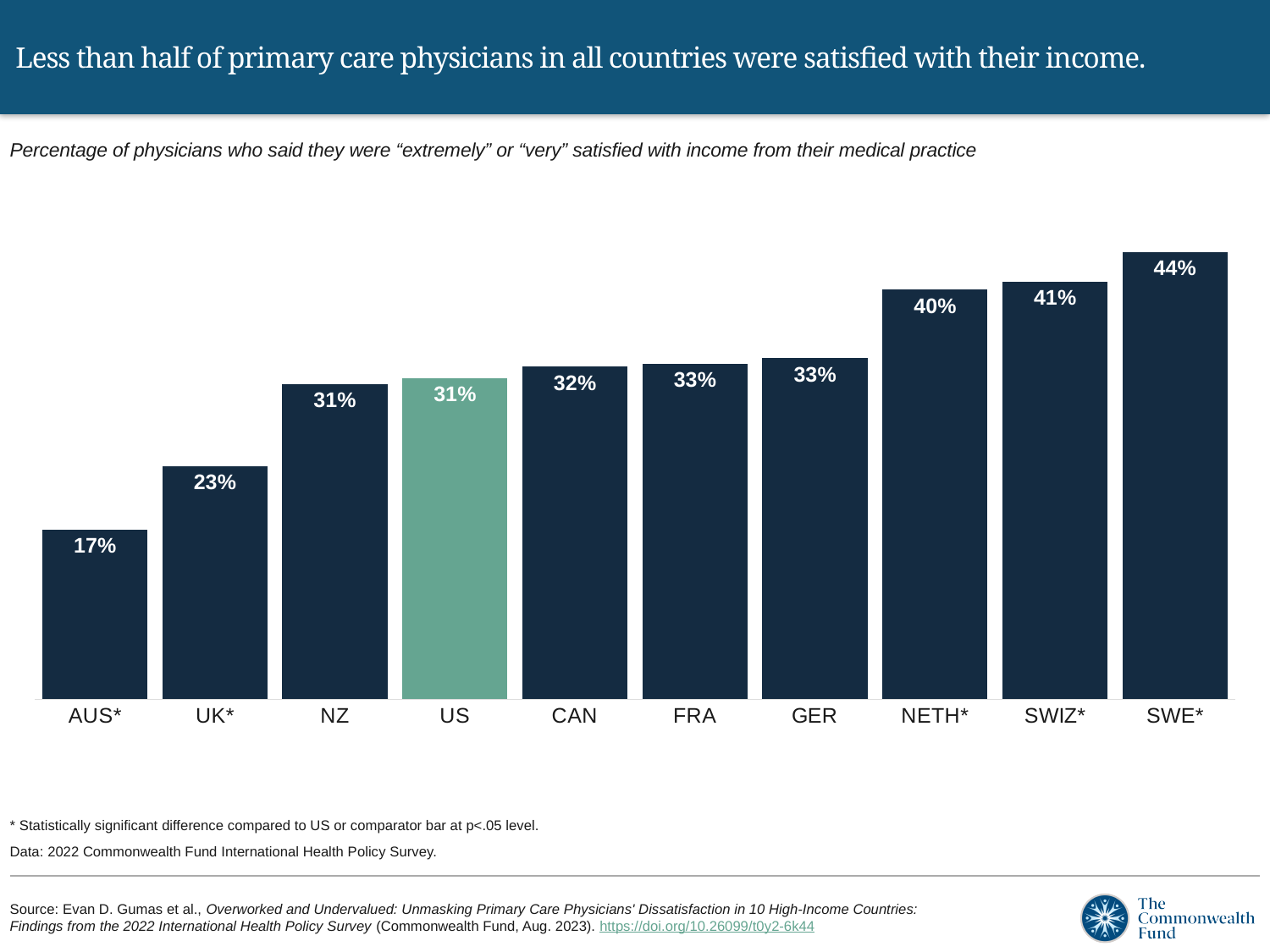
What type of chart is shown on the slide? Bar chart What is the value shown for AUS*? 17% Do the values generally rise or fall from left to right across the chart? Rise What is the difference in percentage points between SWIZ* and UK*? 18 Which country has the highest percentage of physicians satisfied with their income? SWE* How many countries are shown in the chart? 10 What percentage of physicians in the US said they were extremely or very satisfied with their income? 31% Which has a higher value, CAN or UK*? CAN What is the value shown for NETH*? 40% Which country has the lowest percentage of physicians satisfied with their income? AUS* What is the difference in percentage points between SWE* and AUS*? 27 Which country's bar is shown in a different colour (green) from the others? US